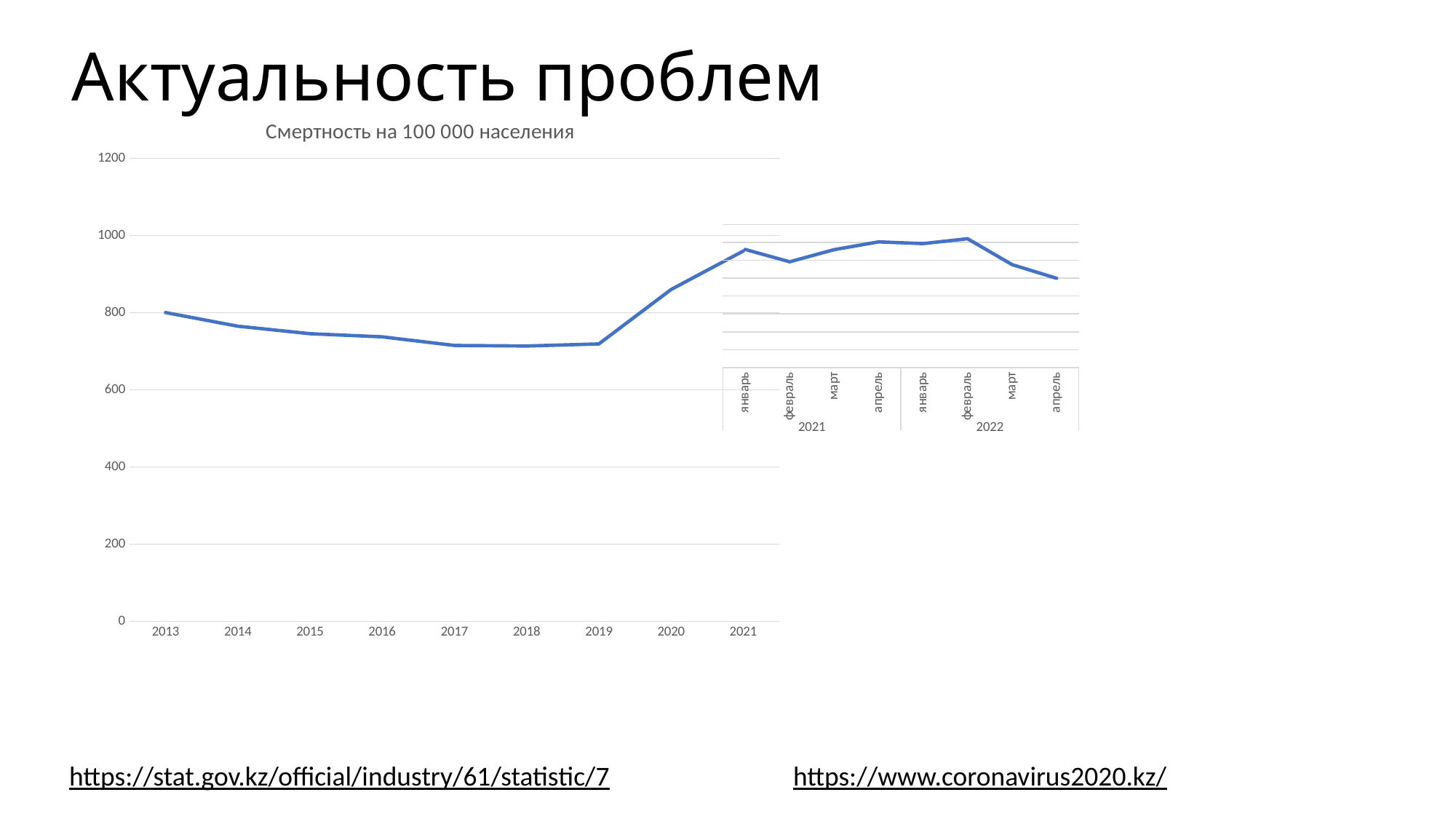
In the inset monthly chart (2021–2022), which month has the lowest value? апрель 2022 In the main chart (years 2013–2021), do the values rise or fall from 2019 to 2021? rise In the inset monthly chart (2021–2022), how many data points are plotted? 8 In the main chart (years 2013–2021), is the value for 2020 greater or less than 800? greater In the main chart (years 2013–2021), is the value for 2021 greater or less than 1000? less In the main chart (years 2013–2021), how many years are shown on the x axis? 9 What kind of chart is the main chart titled 'Смертность на 100 000 населения'? line chart What is the title of the main chart? Смертность на 100 000 населения In the main chart (years 2013–2021), which year has the highest value? 2021 In the main chart (years 2013–2021), do the values rise or fall from 2013 to 2017? fall In the main chart (years 2013–2021), is the value for 2017 greater or less than 800? less In the main chart (years 2013–2021), which is larger, the value for 2013 or the value for 2019? 2013